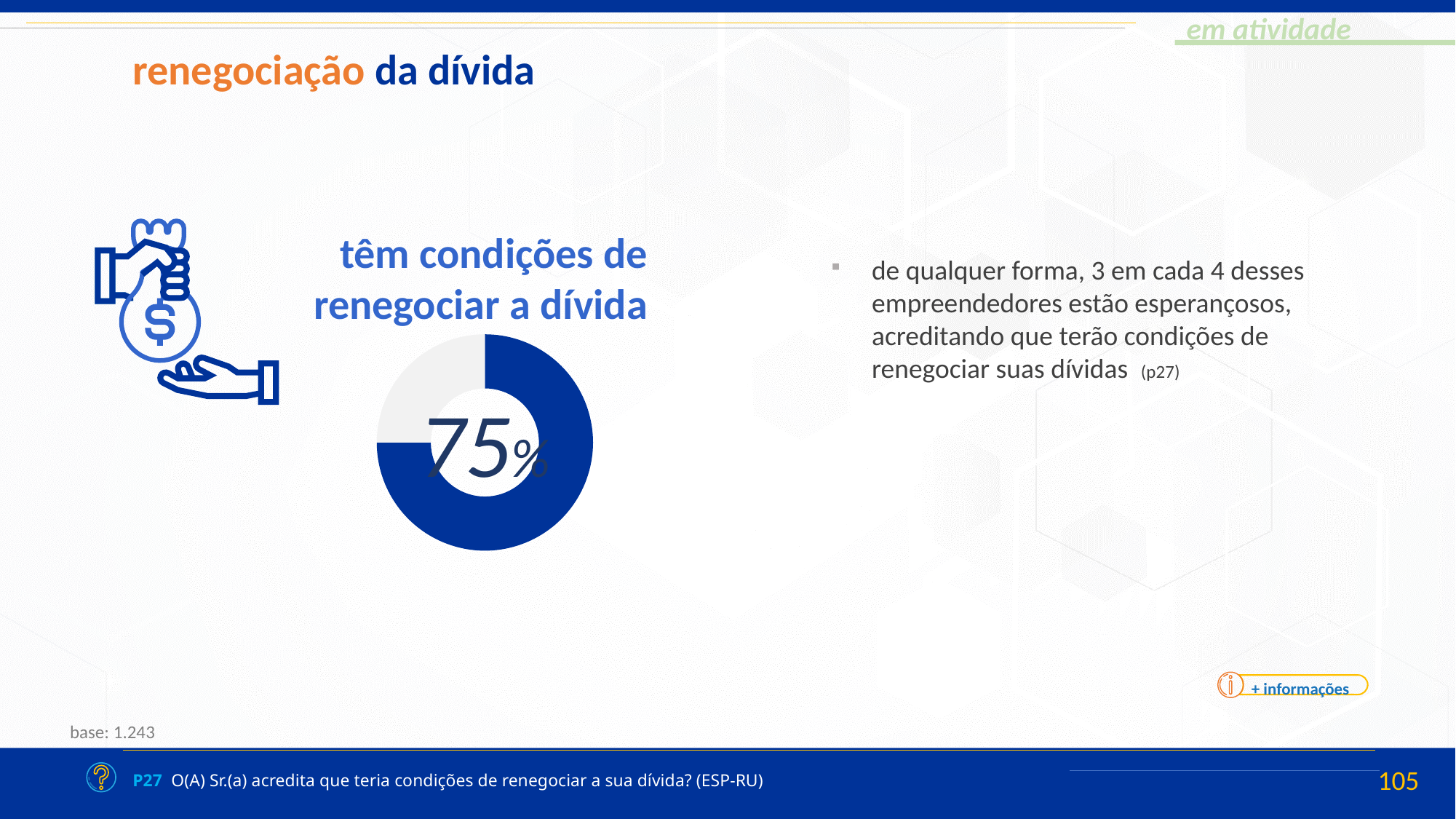
What is the heading printed above the donut chart? têm condições de renegociar a dívida What kind of chart is shown on the slide? pie chart (donut) What share of the donut chart is left for the grey slice? 25% Which slice of the donut chart is larger, the dark blue one or the grey one? the dark blue one What base (sample size) is stated for the chart on the slide? 1.243 What share of the donut chart does the dark blue slice represent? 75% How many slices does the donut chart have? 2 Is the value shown in the donut chart greater or less than 50%? greater What percentage is printed in the centre of the donut chart? 75%